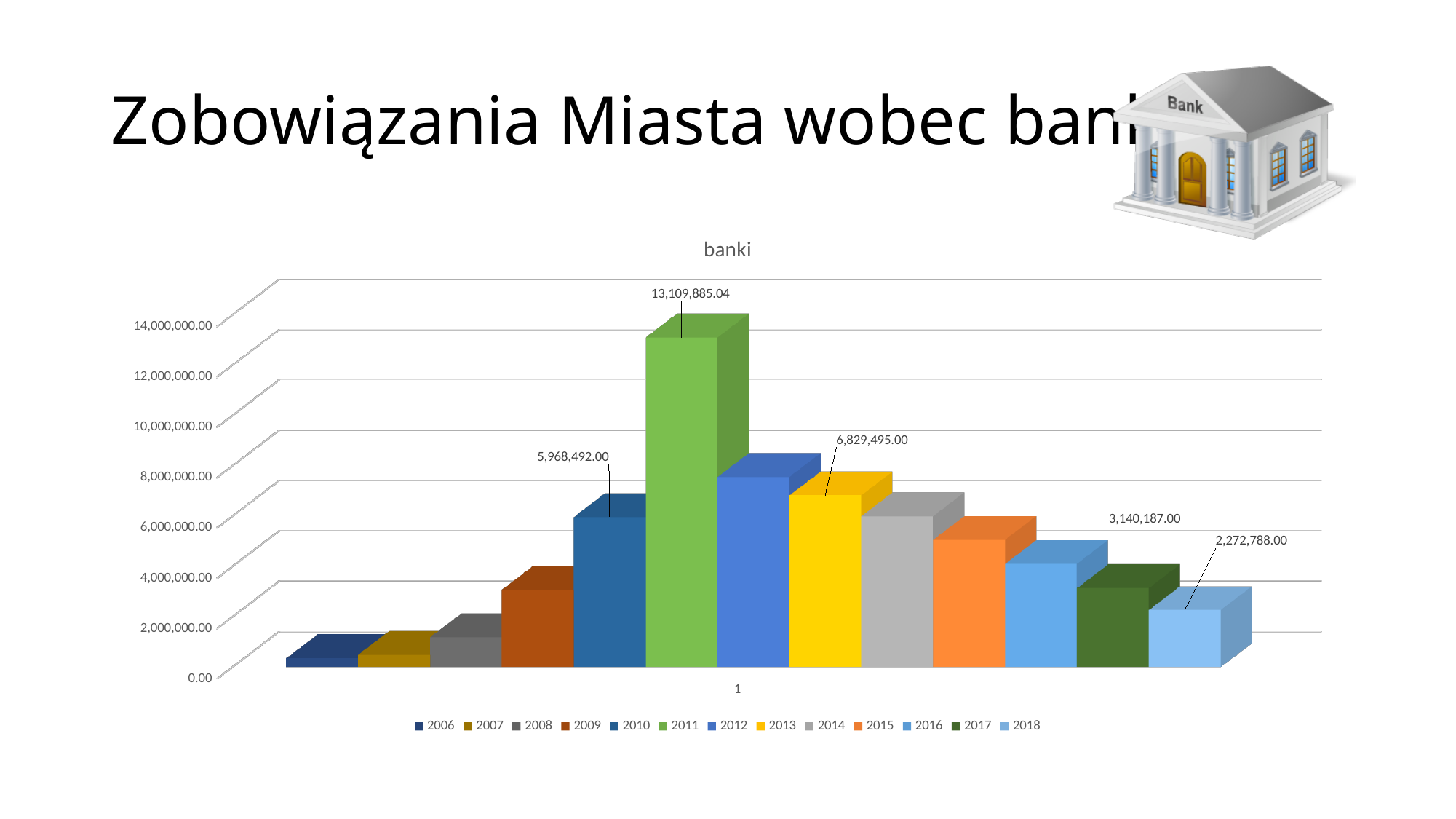
What is the value for 2011 in the chart? 13,109,885.04 Is the value for 2006 greater or less than 2,000,000.00? less Is the value for 2015 greater or less than 4,000,000.00? greater What is the value for 2018 in the chart? 2,272,788.00 What is the value for 2013 in the chart? 6,829,495.00 What is the difference between the values for 2017 and 2018? 867,399.00 Which year has the highest value in the chart? 2011 How many series does the legend list? 13 What type of chart is shown on the slide? bar chart What is the difference between the values for 2011 and 2013? 6,280,390.04 Which is larger, the value for 2012 or the value for 2013? 2012 What is the value for 2010 in the chart? 5,968,492.00